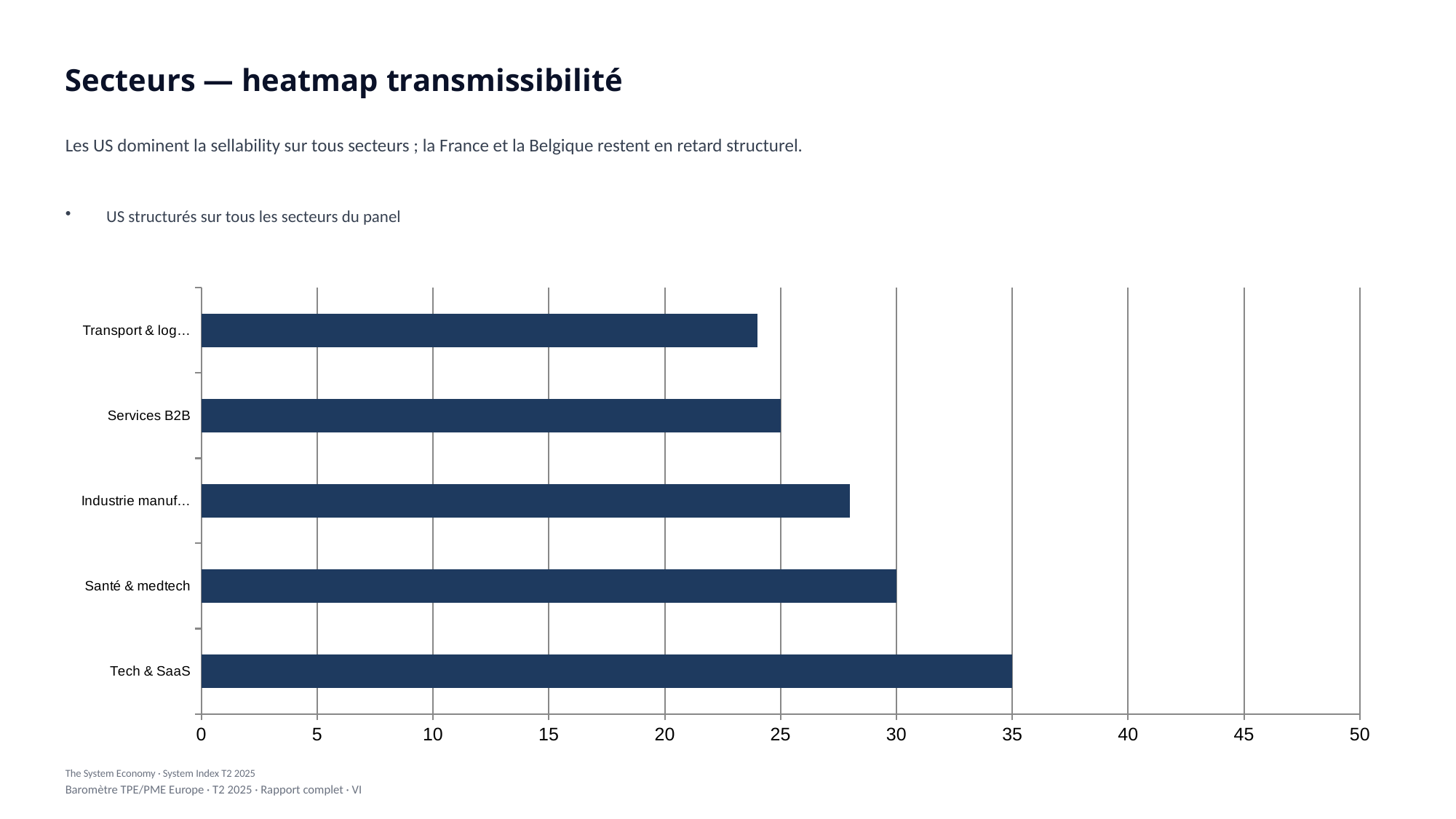
Which sector has the highest value? Tech & SaaS Is the value for Transport & log… greater or less than 30? less What kind of chart is shown on the slide? bar chart What is the value for Services B2B? 25 What is the title of the slide containing the chart? Secteurs — heatmap transmissibilité Is the value for Industrie manuf… greater or less than 25? greater What is the difference between the values for Tech & SaaS and Santé & medtech? 5 Which is larger, the value for Santé & medtech or the value for Services B2B? Santé & medtech What is the value for Santé & medtech? 30 What is the difference between the values for Tech & SaaS and Services B2B? 10 How many sectors are plotted in the chart? 5 What is the value for Tech & SaaS? 35